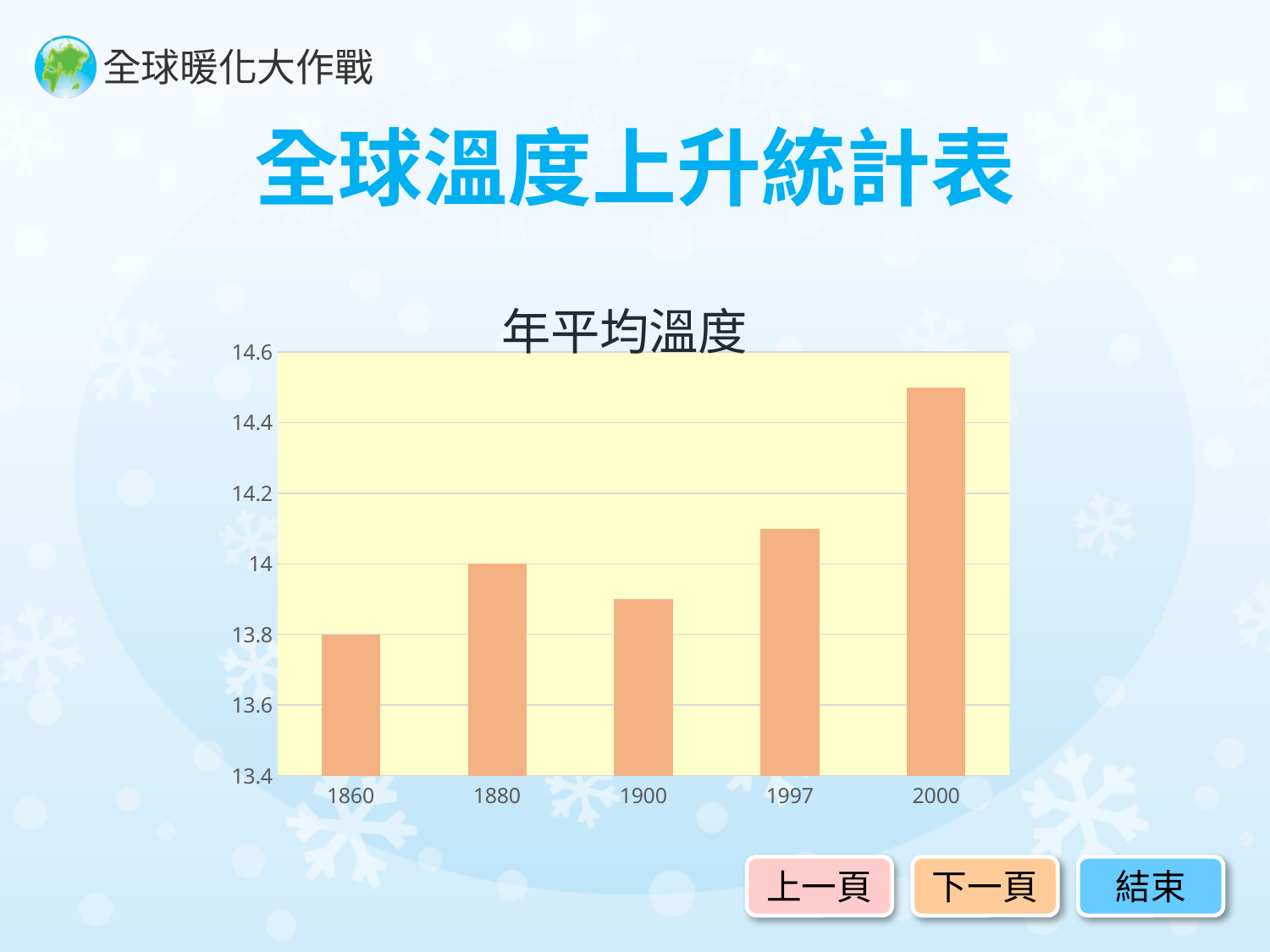
Is the value for 1900 greater or less than 14? less What kind of chart is shown on the slide? bar chart How many years are shown on the x axis of the chart? 5 What is the difference between the values for 1880 and 1860? 0.2 Which year has the highest value? 2000 Which year has the lowest value? 1860 Do the values rise or fall from 1900 to 2000? rise What is the value for 1880? 14 What is the value for 1860? 13.8 Which is larger, the value for 1997 or the value for 2000? 2000 Is the value for 2000 greater or less than 14.4? greater What is the title of the chart? 年平均溫度